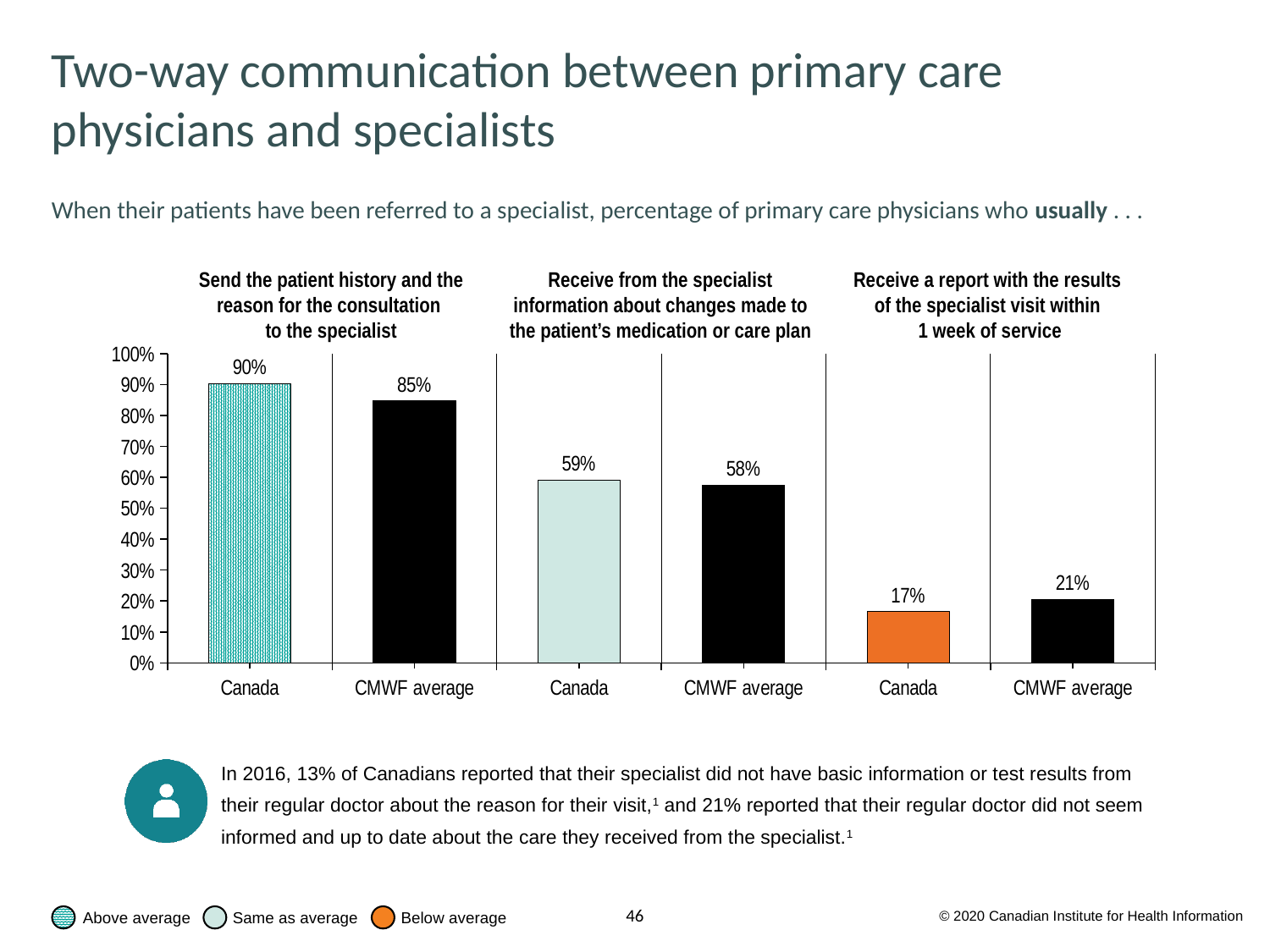
Which bar on the chart has the highest value? Canada, send the patient history and the reason for the consultation to the specialist (90%) For receiving a report with the results of the specialist visit within 1 week of service, which is larger: Canada or the CMWF average? CMWF average According to the legend at the bottom of the slide, what does the orange bar colour indicate? Below average Is the value for Canada for receiving information about changes made to the patient's medication or care plan greater or less than 50%? greater What kind of chart is shown on the slide? Bar chart What is the CMWF average for physicians who usually receive from the specialist information about changes made to the patient's medication or care plan? 58% How many bars are plotted on the chart? 6 Which bar on the chart has the lowest value? Canada, receive a report with the results of the specialist visit within 1 week of service (17%) What is the value for Canada for receiving a report with the results of the specialist visit within 1 week of service? 17% What is the CMWF average for receiving a report with the results of the specialist visit within 1 week of service? 21% What percentage of Canadian primary care physicians usually send the patient history and the reason for the consultation to the specialist? 90% What is the difference between Canada and the CMWF average for sending the patient history and the reason for the consultation to the specialist? 5 percentage points